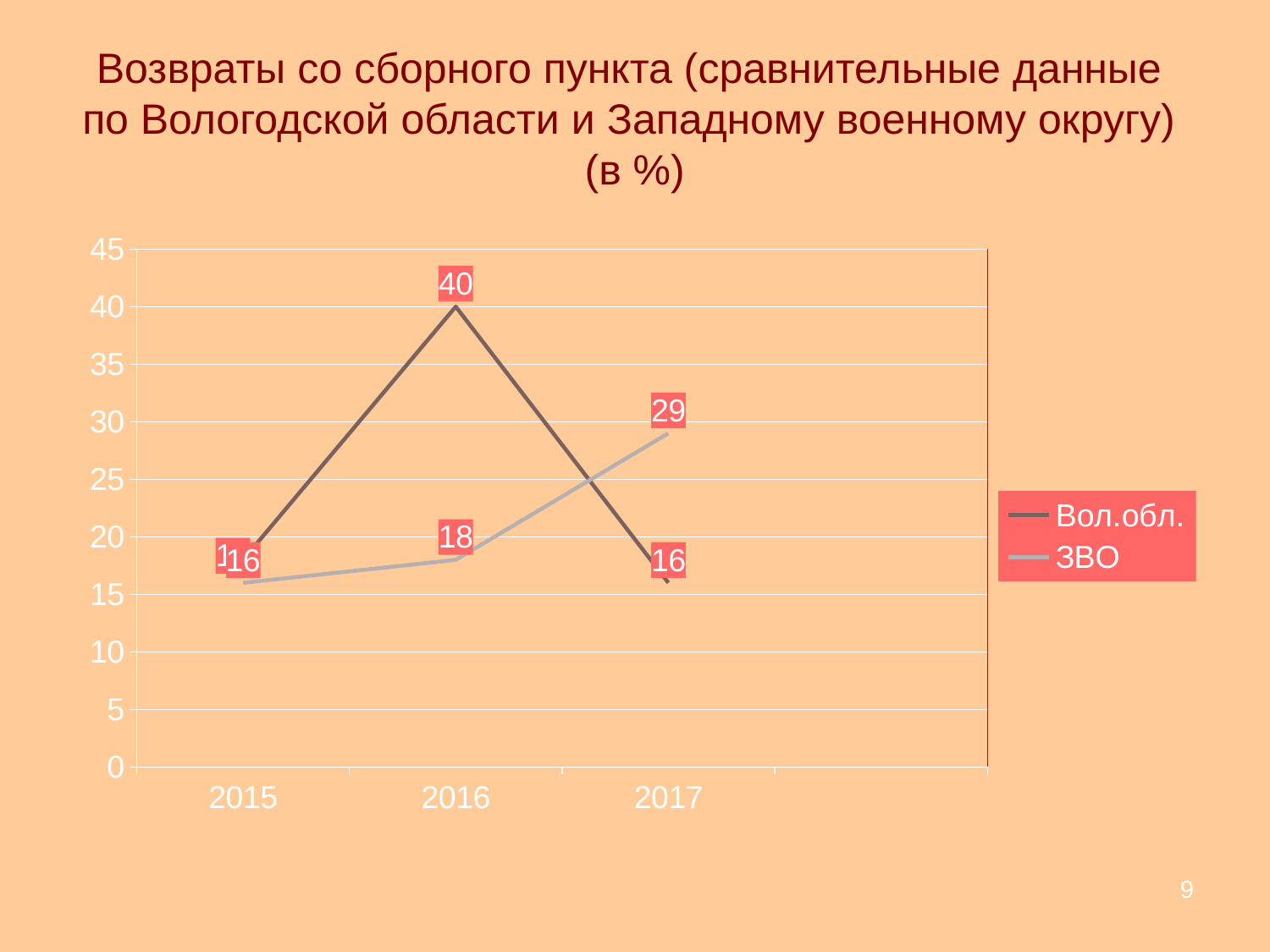
What is the difference between the ЗВО and Вол.обл. values in 2017? 13 What is the value for ЗВО in 2015? 16 What kind of chart is shown on the slide? line chart What is the value for ЗВО in 2016? 18 Which series has the larger value in 2016, Вол.обл. or ЗВО? Вол.обл. In which year is the value for Вол.обл. highest? 2016 Do the values for ЗВО rise or fall from 2015 to 2017? rise How many years are plotted along the x axis? 3 What is the value for Вол.обл. in 2017? 16 What is the value for Вол.обл. in 2016? 40 How many series does the legend list? 2 What is the value for ЗВО in 2017? 29